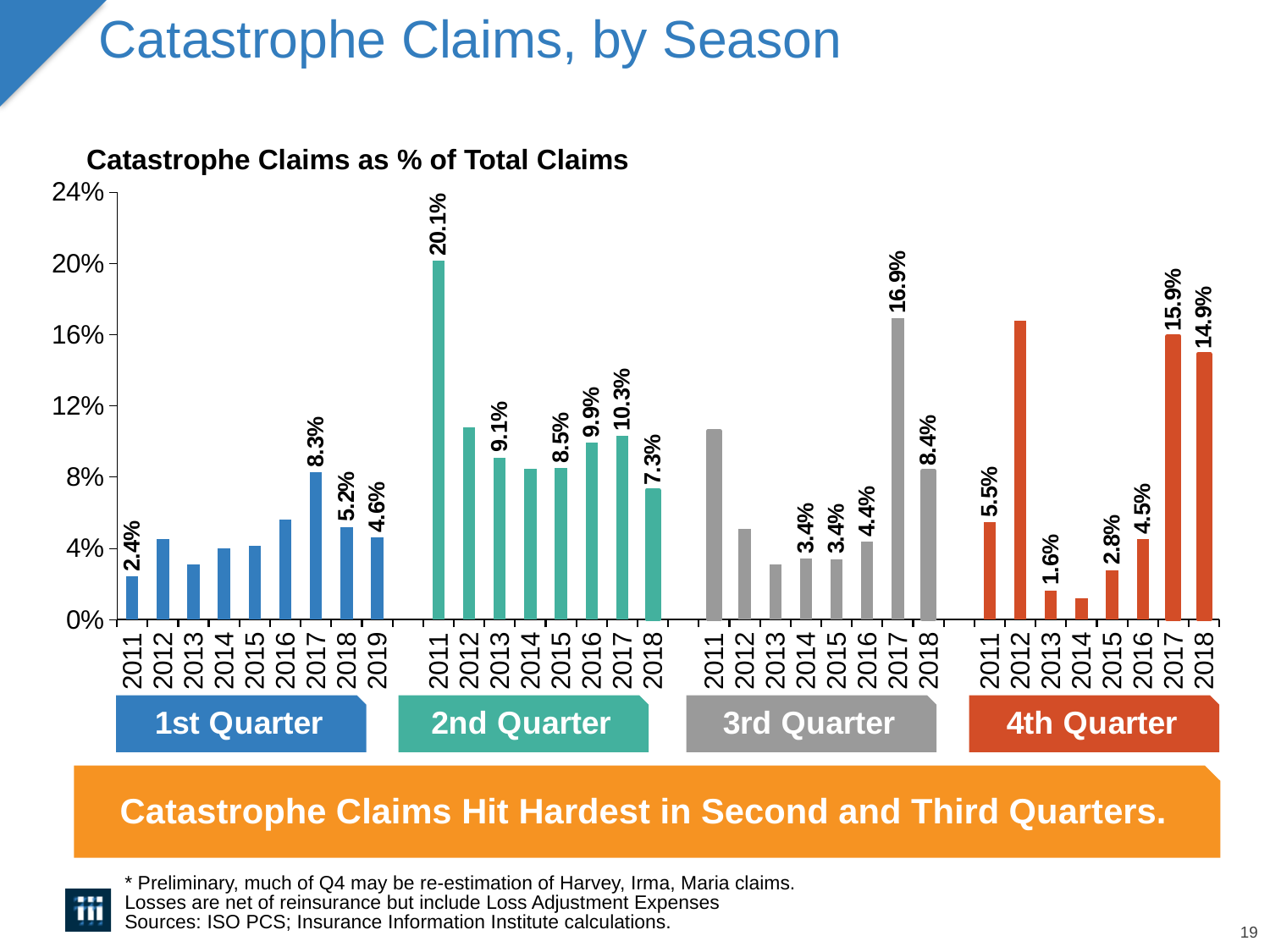
Is the value for 2012 in the 4th Quarter group greater or less than 16%? greater What is the difference between the 4th Quarter values for 2017 and 2018? 1.0 percentage point What type of chart is shown on the slide? Bar chart How many bars are in the 1st Quarter group? 9 What is the catastrophe claims percentage for 2011 in the 2nd Quarter group? 20.1% Within the 1st Quarter group, which year has the lowest value? 2011 (2.4%) What is the value for 2013 in the 4th Quarter group? 1.6% What is the difference between the 1st Quarter values for 2017 and 2018? 3.1 percentage points Is the value for 2011 in the 3rd Quarter group greater or less than 8%? greater What is the value for 2017 in the 3rd Quarter group? 16.9% Which bar is the highest on the whole chart? 2011, 2nd Quarter (20.1%) In the 2nd Quarter group, which is larger: 2016 or 2017? 2017